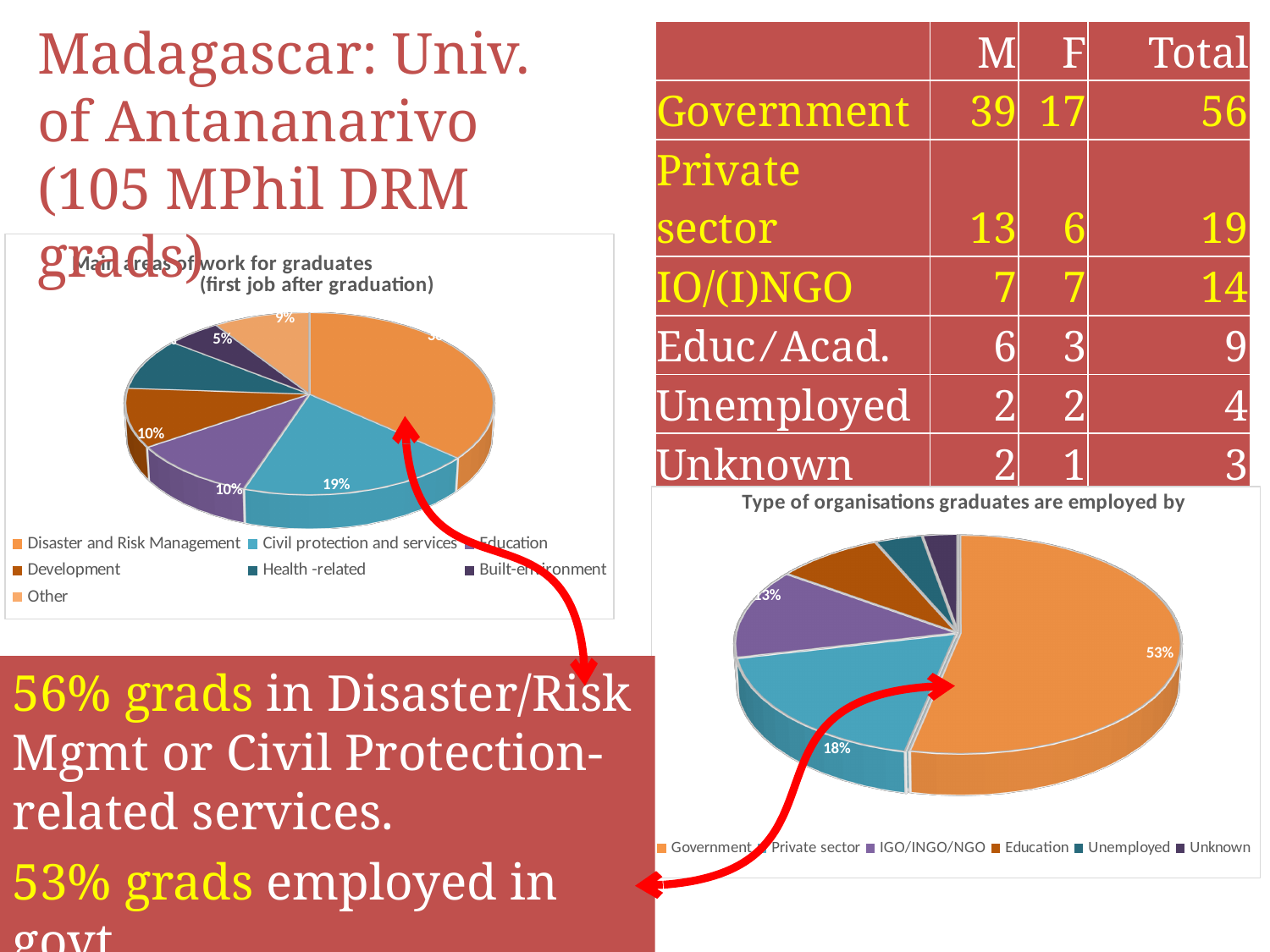
What is the title of the pie chart on the right side of the slide? Type of organisations graduates are employed by In the 'Type of organisations graduates are employed by' chart, what share of the pie is Private sector? 18% How many entries does the legend of the 'Main areas of work for graduates' chart list? 7 In the 'Type of organisations graduates are employed by' chart, which category has the largest slice? Government In the 'Main areas of work for graduates' chart, which category has the largest slice? Disaster and Risk Management In the 'Type of organisations graduates are employed by' chart, which is larger, Government or Private sector? Government In the 'Type of organisations graduates are employed by' chart, what is the difference in percentage points between the Government and Private sector slices? 35 How many entries does the legend of the 'Type of organisations graduates are employed by' chart list? 6 What kind of chart is the chart titled 'Main areas of work for graduates (first job after graduation)'? pie chart In the 'Type of organisations graduates are employed by' chart, what share of the pie is Government? 53% In the 'Main areas of work for graduates' chart, what share of the pie is Built-environment? 5%